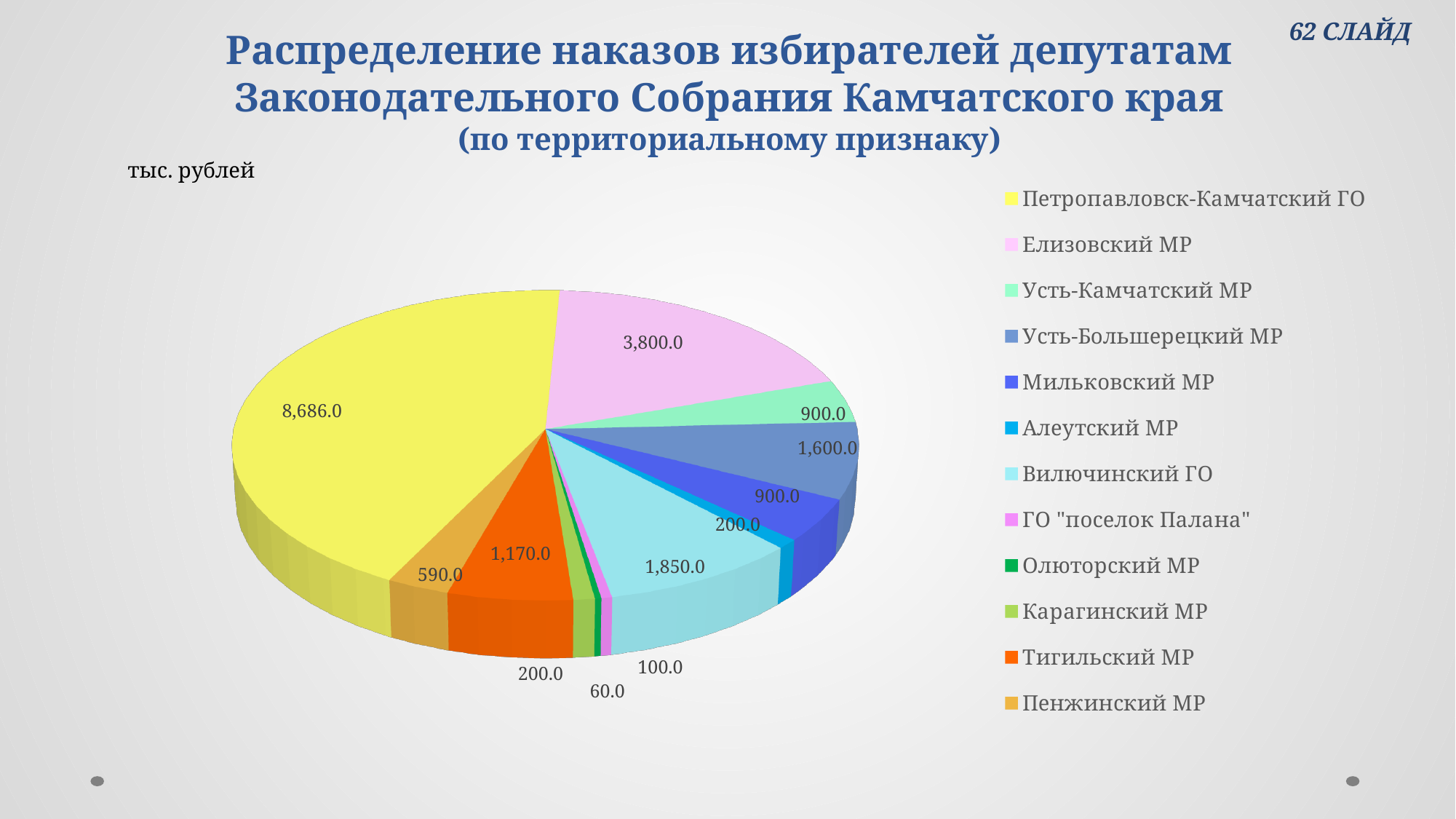
What is the value for Вилючинский ГО? 1,850.0 What kind of chart is shown on the slide? pie chart What is the value for Елизовский МР? 3,800.0 Which is larger, the value for Вилючинский ГО or the value for Усть-Большерецкий МР? Вилючинский ГО What unit of measurement is indicated for the chart values? тыс. рублей Which category has the largest slice? Петропавловск-Камчатский ГО Which category has the smallest slice? Олюторский МР How many categories (slices) does the pie chart have? 12 What is the value for Тигильский МР? 1,170.0 What is the difference between the values for Елизовский МР and Усть-Большерецкий МР? 2,200.0 What is the total of all the values shown on the pie chart? 20,056.0 What is the value for Петропавловск-Камчатский ГО? 8,686.0